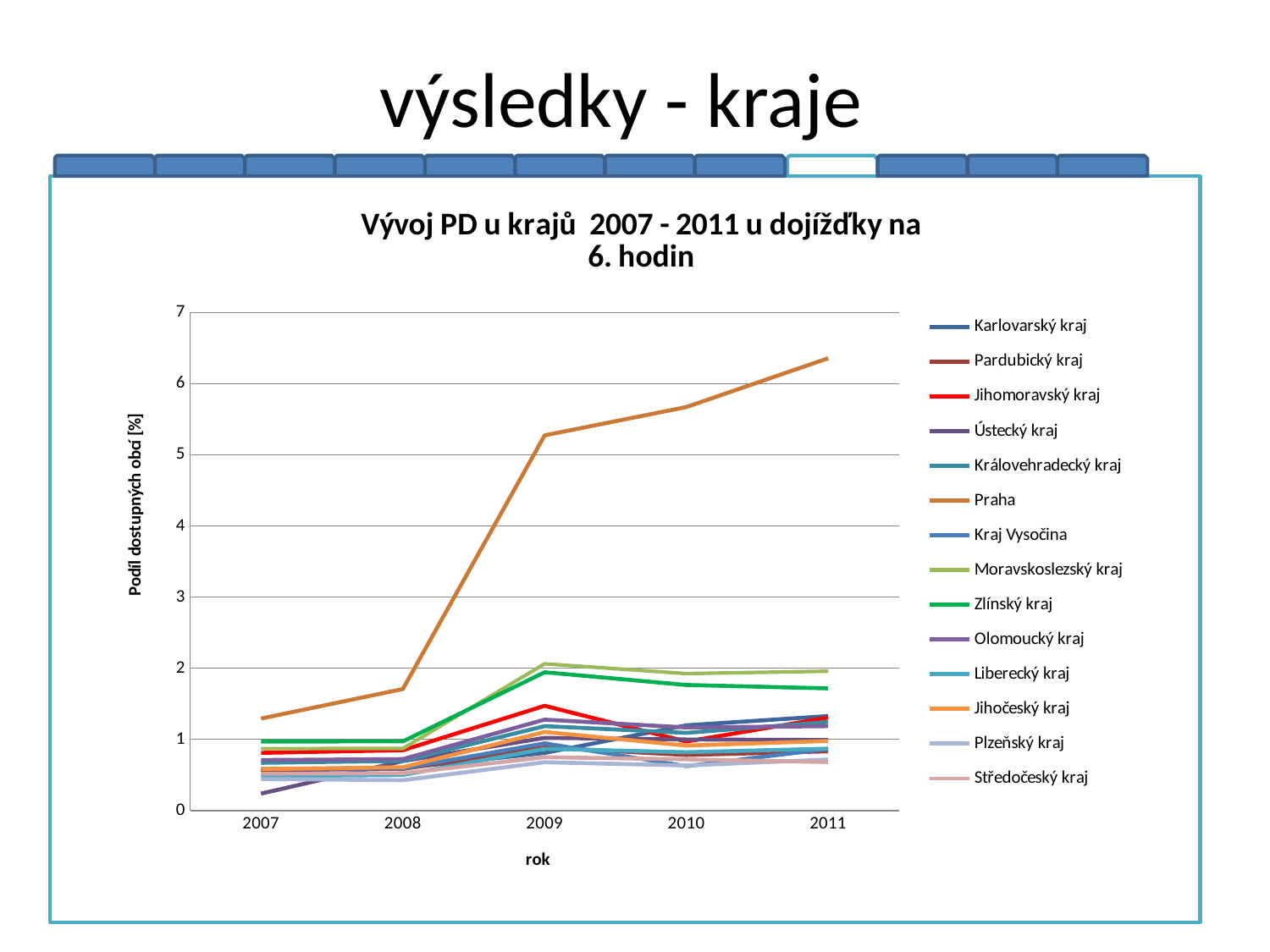
Which is larger in 2011, the value for Praha or the value for Zlínský kraj? Praha Is the value for Praha in 2009 greater or less than 5? greater How many years are shown on the x axis? 5 What is the label of the y axis? Podíl dostupných obcí [%] How many series does the legend list? 14 Is the value for Praha in 2008 greater or less than 2? less What kind of chart is shown on the slide? line chart Is the value for Zlínský kraj in 2011 greater or less than 2? less Which region has the highest value in 2009? Praha Which region has the highest value in 2011? Praha Does the value for Praha rise or fall from 2007 to 2011? rise